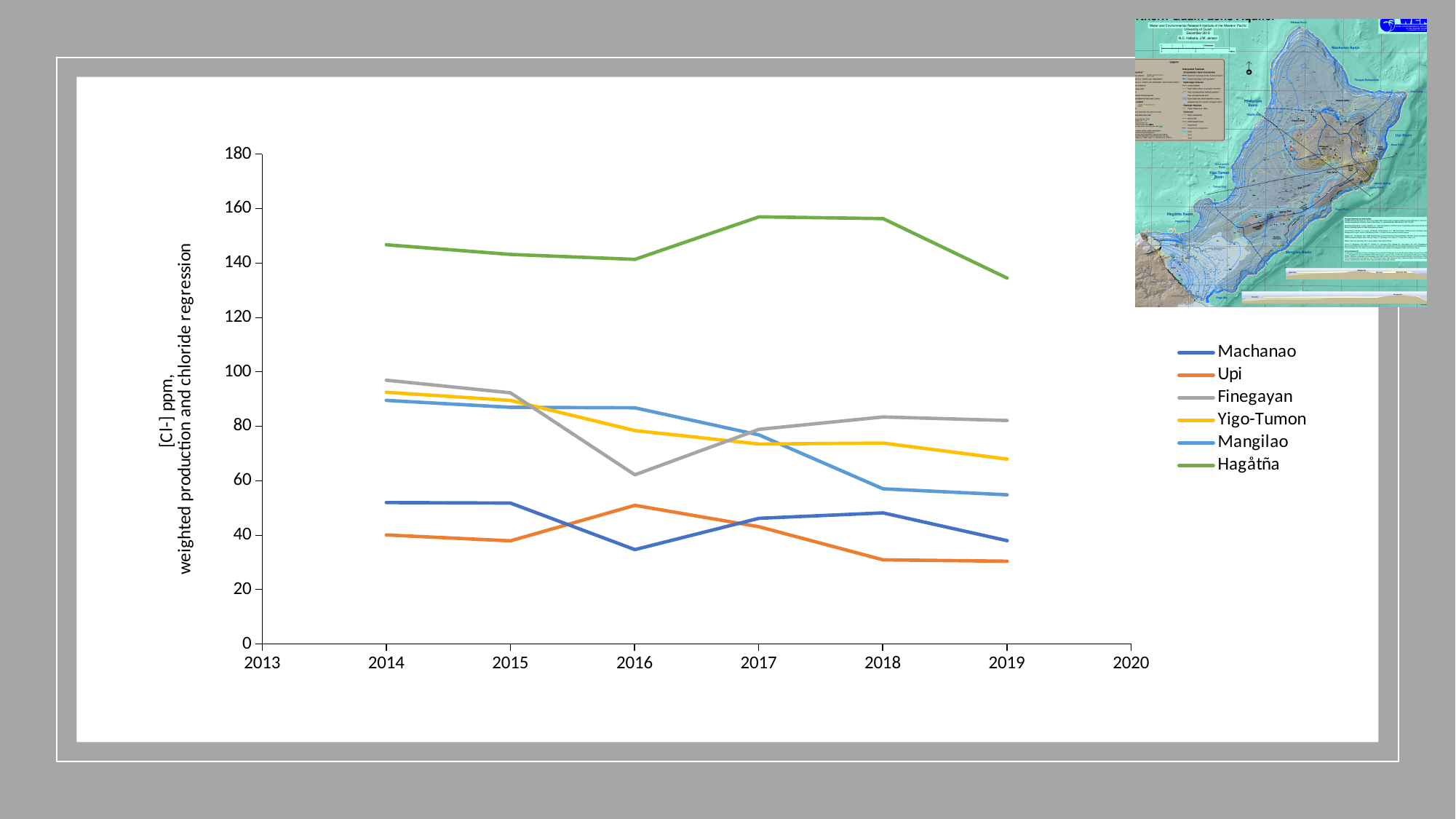
Is the value for Hagåtña in 2017 greater or less than 140? greater What colour is the Hagåtña line in the chart? green Is the value for Yigo-Tumon in 2019 greater or less than 60? greater Which series has the lowest value in 2019? Upi Which series has the highest chloride values across all years? Hagåtña How many series does the legend list? 6 What kind of chart is shown on the slide? line chart In 2018, which is higher, Finegayan or Yigo-Tumon? Finegayan In 2016, which is higher, Upi or Machanao? Upi How many years have data points plotted for each series? 6 Is the value for Finegayan in 2016 greater or less than 80? less Does the Mangilao series rise or fall from 2014 to 2019? fall